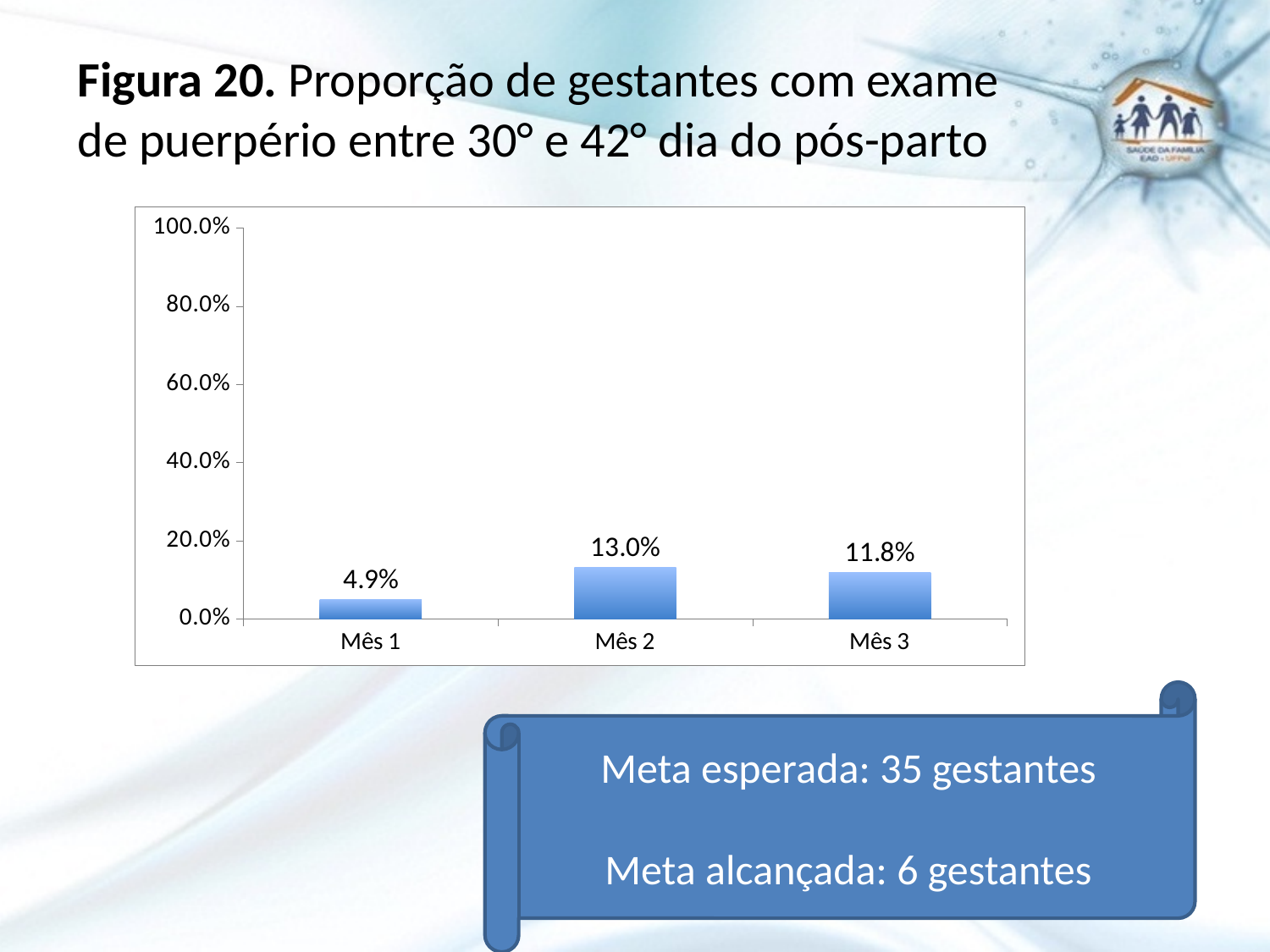
Which is larger, the value for Mês 1 or the value for Mês 3? Mês 3 How many categories are shown on the x axis? 3 What is the difference between the values for Mês 2 and Mês 1? 8.1% Is the value for Mês 2 greater or less than 20.0%? less What is the highest tick value shown on the y axis? 100.0% What kind of chart is shown on the slide? bar chart What is the value for Mês 1? 4.9% What is the difference between the values for Mês 2 and Mês 3? 1.2% Which month has the highest value? Mês 2 Which month has the lowest value? Mês 1 What is the value for Mês 3? 11.8% What is the value for Mês 2? 13.0%